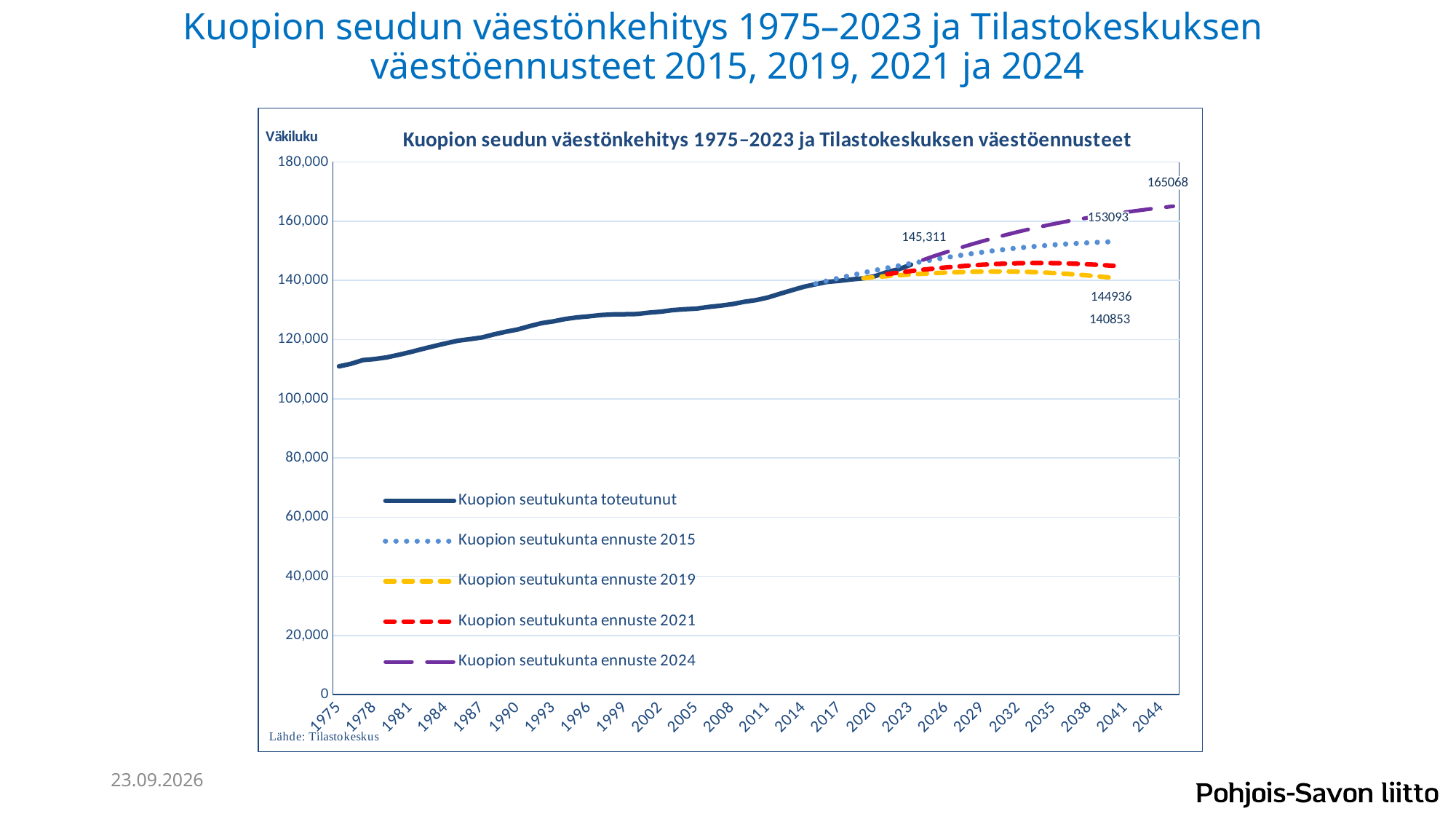
What is the final labelled value of the 'Kuopion seutukunta ennuste 2024' series? 165068 What type of chart is shown on the slide? line chart What is the final labelled value of the 'Kuopion seutukunta ennuste 2015' series? 153093 Which forecast series ends at the lowest value? Kuopion seutukunta ennuste 2019 How many series does the legend list? 5 Is the value of the 'Kuopion seutukunta toteutunut' series in 1975 greater or less than 120,000? less What is the final labelled value of the 'Kuopion seutukunta ennuste 2021' series? 144936 Which forecast series ends at the highest value? Kuopion seutukunta ennuste 2024 What is the final labelled value of the 'Kuopion seutukunta ennuste 2019' series? 140853 Does the 'Kuopion seutukunta toteutunut' series rise or fall from 1975 to 2023? rises What is the difference between the final values of the 2024 forecast (165068) and the 2019 forecast (140853)? 24215 What is the labelled value at the end of the 'Kuopion seutukunta toteutunut' series in 2023? 145,311